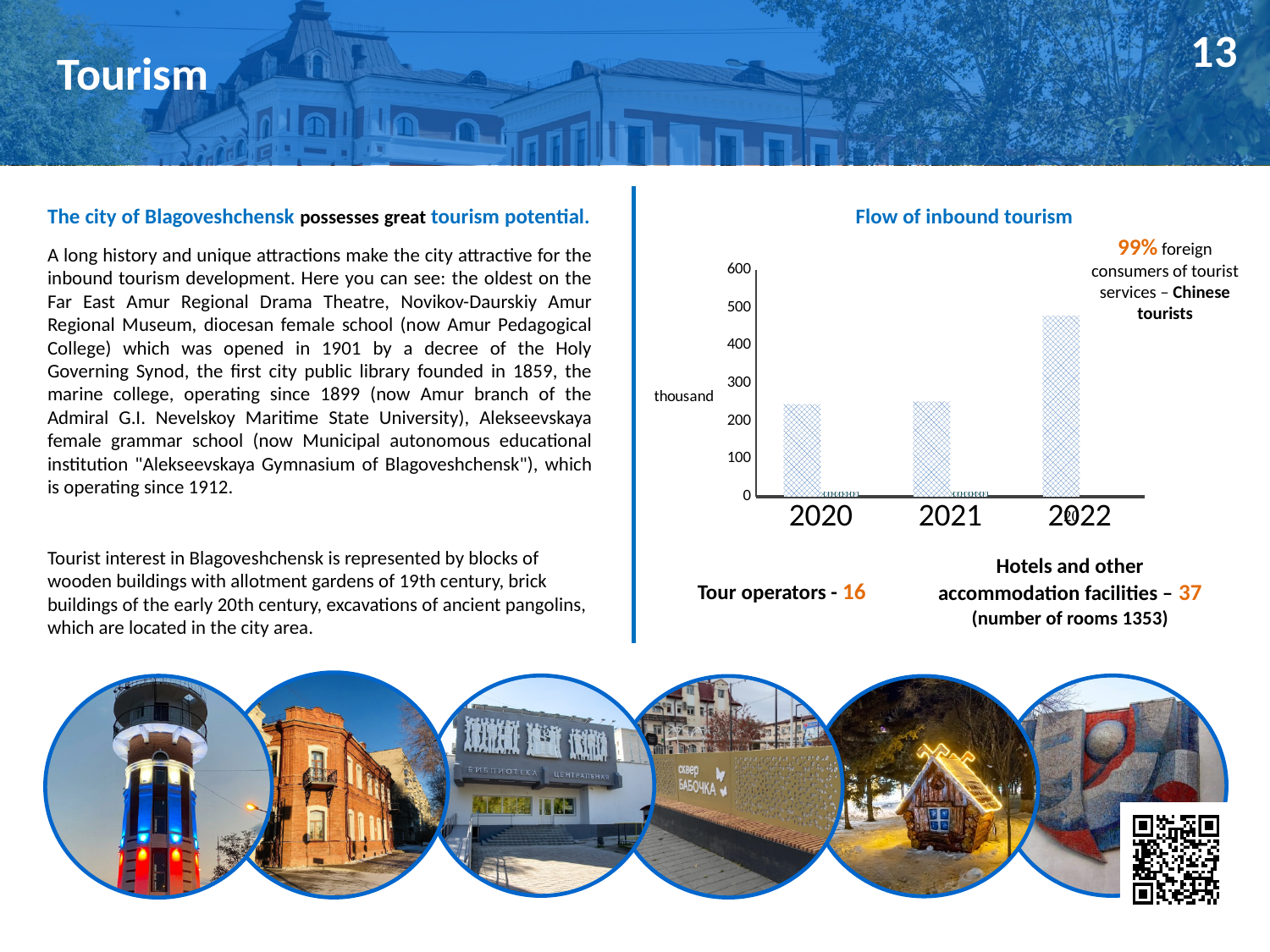
On the "Flow of inbound tourism" chart, is the value for 2021 greater or less than 200? greater What is the title of the chart on the slide? Flow of inbound tourism On the "Flow of inbound tourism" chart, is the value for 2020 greater or less than 300? less What is the highest tick value shown on the vertical axis of the "Flow of inbound tourism" chart? 600 On the "Flow of inbound tourism" chart, is the value for 2022 greater or less than 500? less Do the values on the "Flow of inbound tourism" chart rise or fall from 2020 to 2022? rise Which year has the highest value on the "Flow of inbound tourism" chart? 2022 What kind of chart is shown under the title "Flow of inbound tourism"? bar chart On the "Flow of inbound tourism" chart, which is larger: the value for 2022 or the value for 2020? 2022 How many years are plotted on the "Flow of inbound tourism" chart? 3 What unit is written next to the vertical axis of the "Flow of inbound tourism" chart? thousand